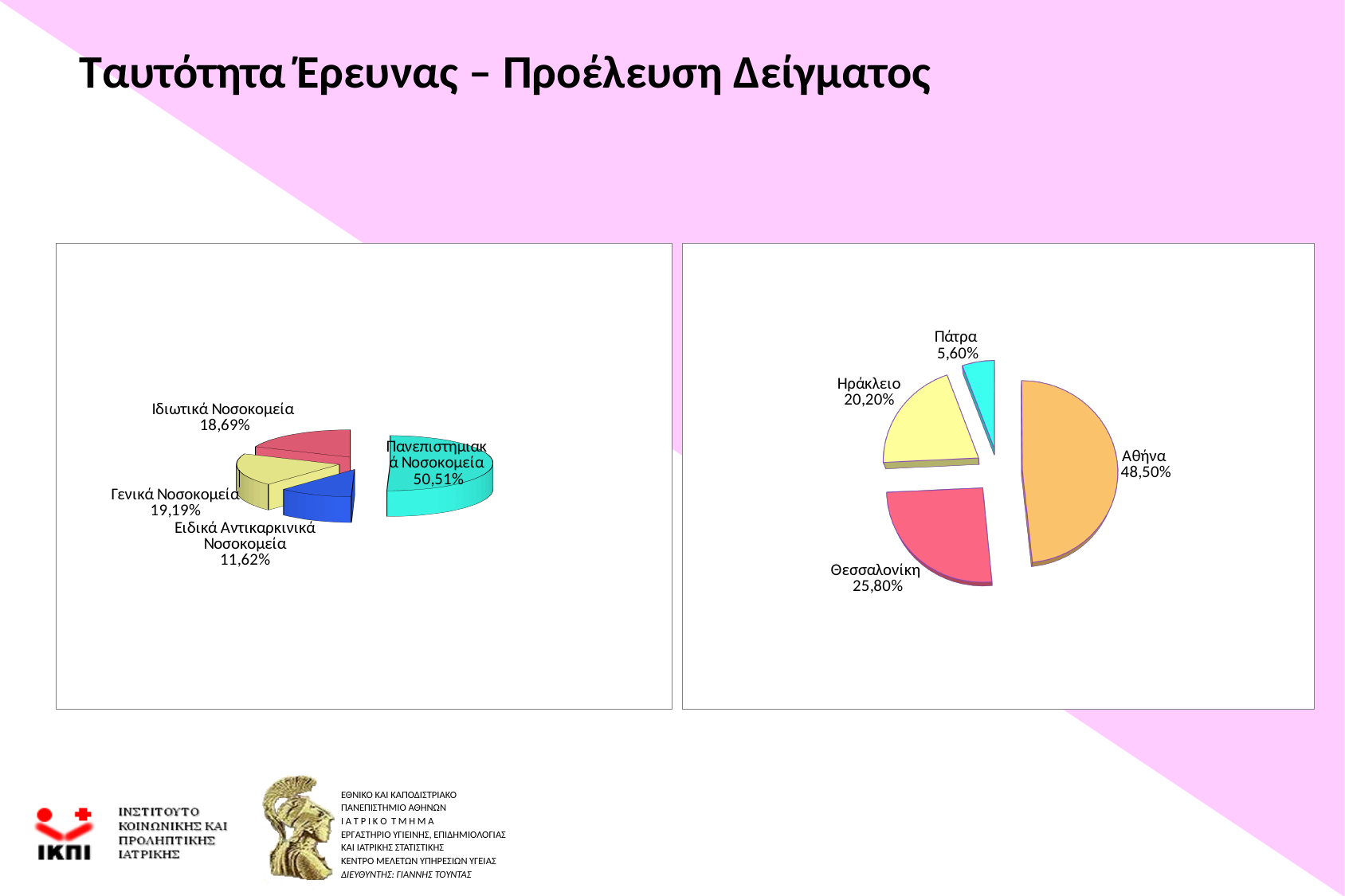
In the right pie chart, what share is shown for Θεσσαλονίκη? 25,80% In the right pie chart, which has the larger share, Ηράκλειο or Θεσσαλονίκη? Θεσσαλονίκη In the left pie chart, which category has the largest share? Πανεπιστημιακά Νοσοκομεία In the right pie chart, what share is shown for Πάτρα? 5,60% In the left pie chart, how many slices are there? 4 In the left pie chart, what share is shown for Πανεπιστημιακά Νοσοκομεία? 50,51% In the left pie chart, what is the difference between the shares of Γενικά Νοσοκομεία and Ιδιωτικά Νοσοκομεία? 0,50% In the left pie chart, which category has the smallest share? Ειδικά Αντικαρκινικά Νοσοκομεία In the left pie chart, what share is shown for Ειδικά Αντικαρκινικά Νοσοκομεία? 11,62% In the right pie chart, which city has the largest share? Αθήνα What type of chart is the right chart? Pie chart In the right pie chart, which city has the smallest share? Πάτρα